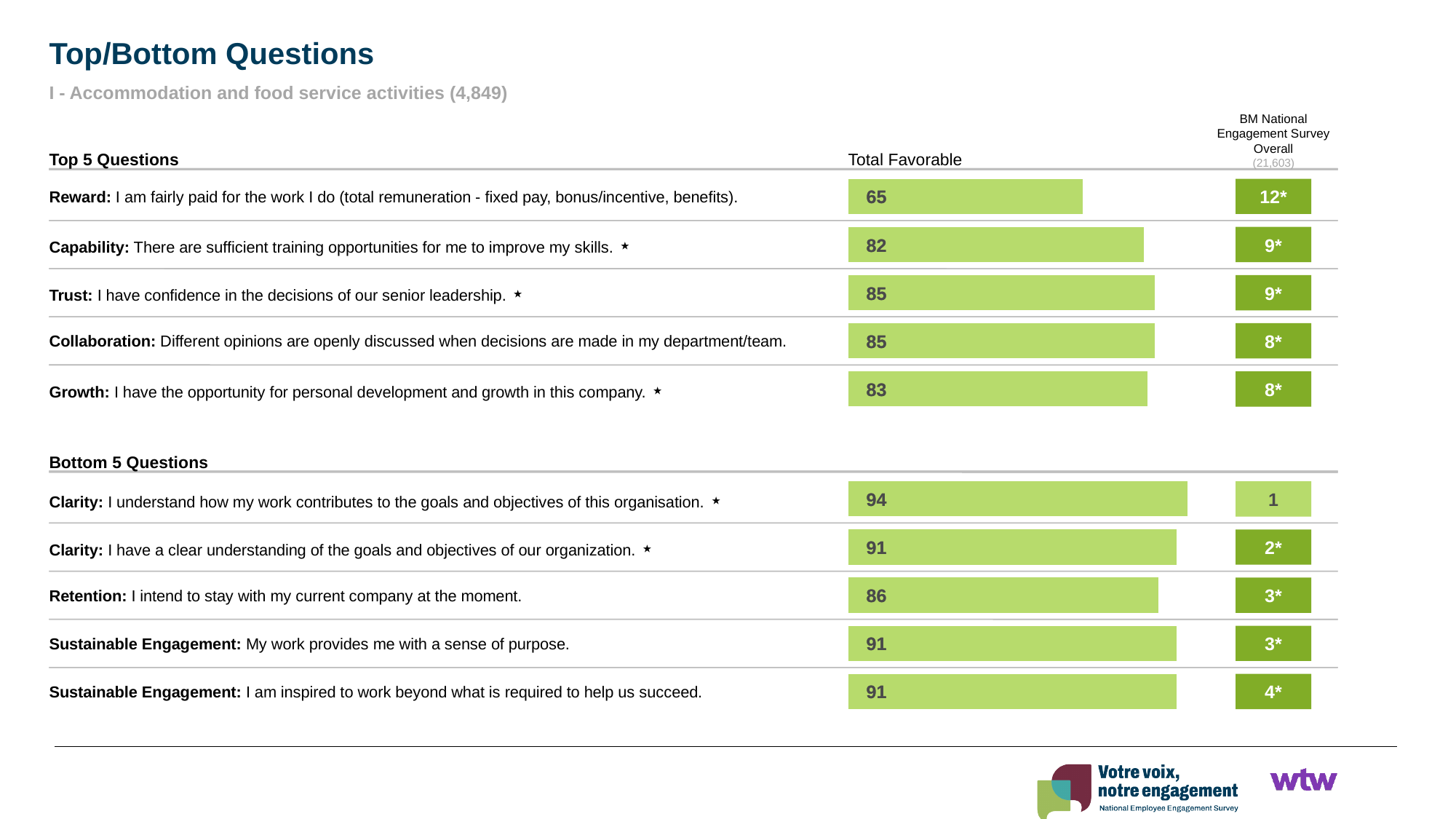
In the Top 5 Questions chart, which question has the lowest Total Favorable value? Reward What is the title of the slide containing these charts? Top/Bottom Questions In the Bottom 5 Questions chart, what is the difference between the Total Favorable values for the first Clarity question (94) and Retention? 8 What kind of chart is used to show the Total Favorable values on this slide? bar chart In the Top 5 Questions chart, what is the Total Favorable value for the Capability question? 82 In the Bottom 5 Questions chart, is the Total Favorable value for Retention larger or smaller than the value for 'Sustainable Engagement: My work provides me with a sense of purpose'? smaller In the Bottom 5 Questions chart, which question has the highest Total Favorable value? Clarity: I understand how my work contributes to the goals and objectives of this organisation. In the Top 5 Questions chart, what is the difference between the Total Favorable values for Trust and Reward? 20 How many questions are plotted in the Bottom 5 Questions chart? 5 In the Top 5 Questions chart, what is the Total Favorable value for the Reward question? 65 In the Top 5 Questions chart, what is the BM National Engagement Survey Overall value shown for the Reward question? 12* In the Bottom 5 Questions chart, what is the Total Favorable value for the Retention question? 86